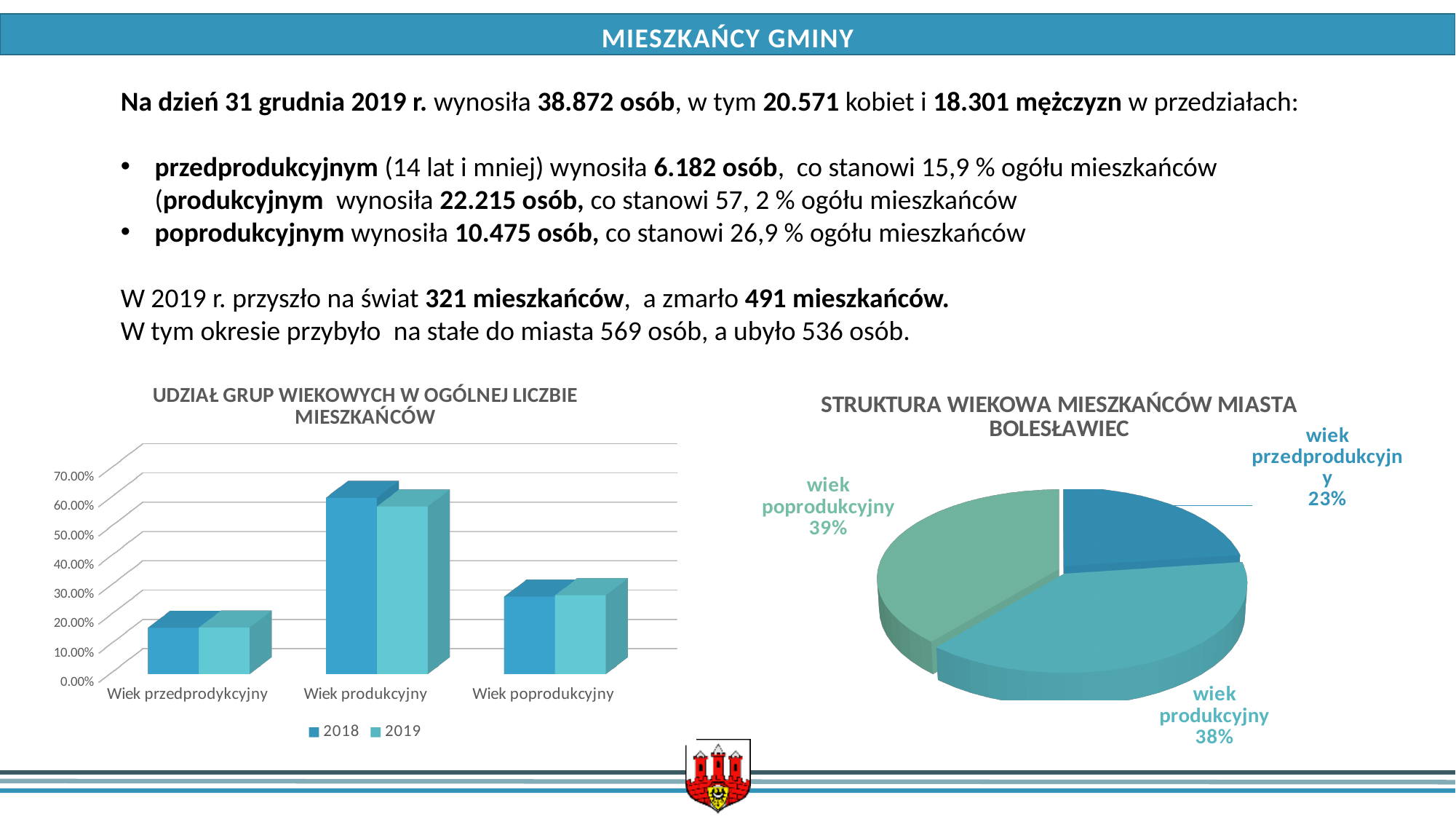
In the left bar chart, is the 2018 value for Wiek produkcyjny greater or less than 50.00%? greater In the left bar chart, how many categories are shown on the x axis? 3 In the left bar chart, is the 2019 value for Wiek przedprodykcyjny greater or less than 20.00%? less In the right pie chart, what share does 'wiek poprodukcyjny' have? 39% In the left bar chart, how many series does the legend list? 2 In the left bar chart, which category has the lowest values? Wiek przedprodykcyjny What kind of chart is the left chart titled 'UDZIAŁ GRUP WIEKOWYCH W OGÓLNEJ LICZBIE MIESZKAŃCÓW'? bar chart In the right pie chart, which slice is the smallest? wiek przedprodukcyjny What kind of chart is the right chart titled 'STRUKTURA WIEKOWA MIESZKAŃCÓW MIASTA BOLESŁAWIEC'? pie chart In the right pie chart, what share does 'wiek przedprodukcyjny' have? 23% In the left bar chart, which category has the highest values? Wiek produkcyjny In the left bar chart, is the 2018 value for Wiek poprodukcyjny greater or less than 20.00%? greater